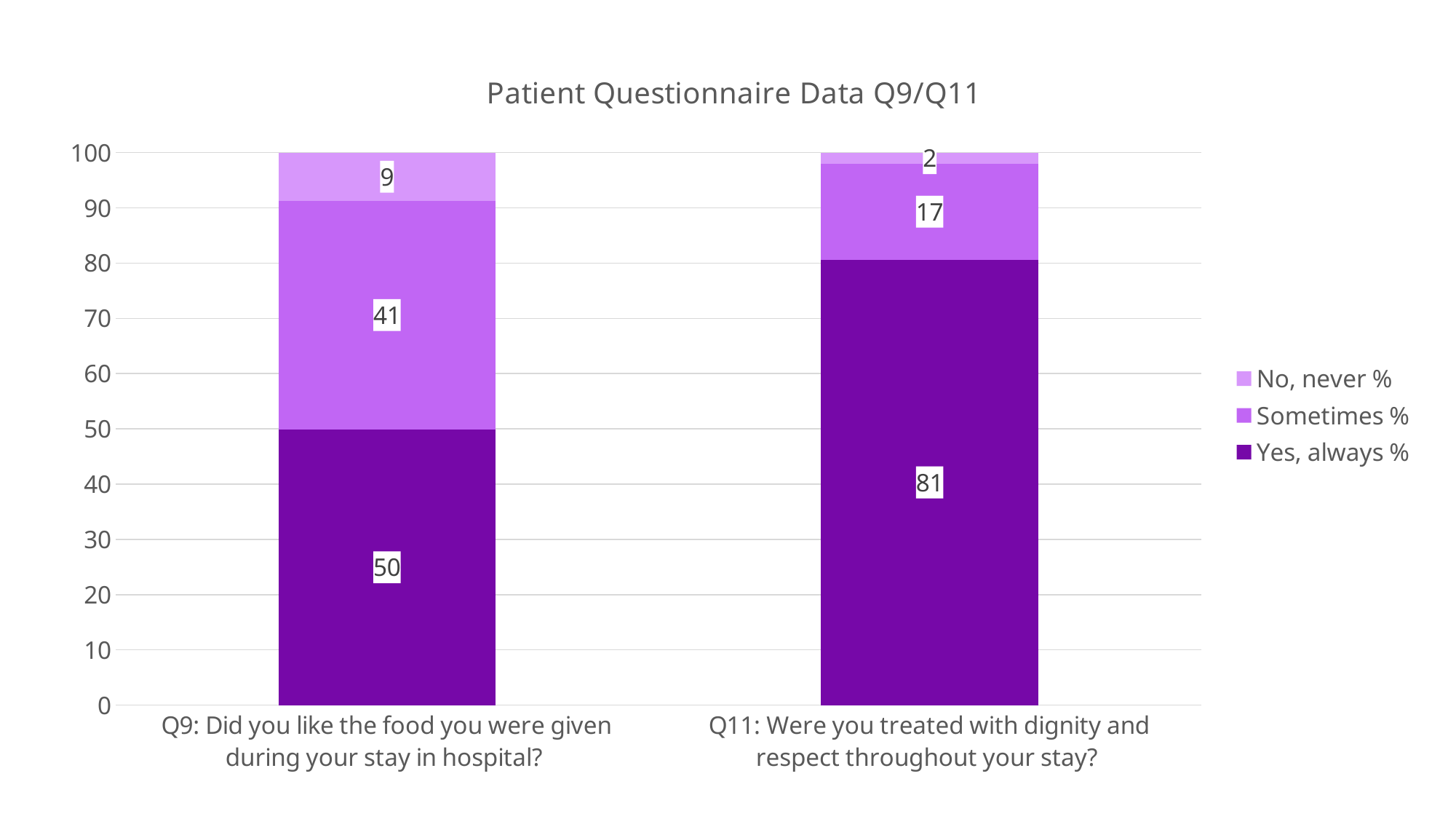
What is the 'Sometimes %' value for Q11: Were you treated with dignity and respect throughout your stay? 17 What is the total of the stacked bar for Q9? 100 What is the 'Yes, always %' value for Q9: Did you like the food you were given during your stay in hospital? 50 Which question has the higher 'Yes, always %' value? Q11: Were you treated with dignity and respect throughout your stay? Which question has the lower 'Sometimes %' value? Q11: Were you treated with dignity and respect throughout your stay? What is the 'No, never %' value for Q9? 9 What is the difference between the 'Yes, always %' values for Q11 and Q9? 31 Is the 'Sometimes %' value larger for Q9 or for Q11? Q9 How many questions (categories) are shown on the x axis? 2 How many series does the legend list? 3 What is the 'No, never %' value for Q11? 2 What kind of chart is shown on the slide? Stacked bar chart